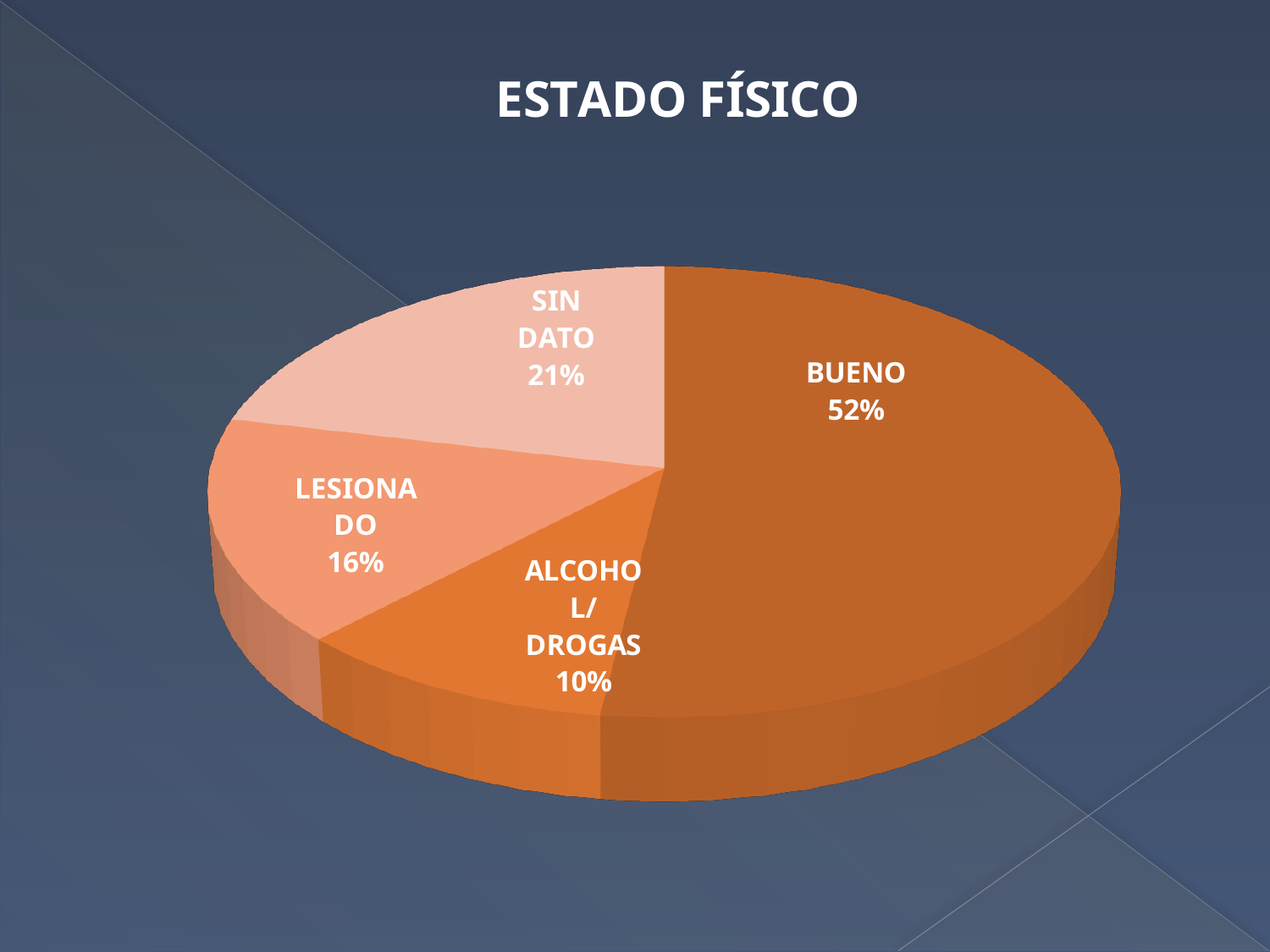
What is the combined share of LESIONADO and ALCOHOL/DROGAS? 26% How many slices does the pie chart have? 4 Which category has the largest share of the pie? BUENO What is the difference in percentage points between BUENO and SIN DATO? 31 What kind of chart is shown on the slide? pie chart Which is larger, the share for LESIONADO or the share for SIN DATO? SIN DATO What percentage is shown for ALCOHOL/DROGAS? 10% What percentage is shown for SIN DATO? 21% What is the title of the chart? ESTADO FÍSICO What percentage is shown for LESIONADO? 16% Which category has the smallest share of the pie? ALCOHOL/DROGAS What percentage is shown for BUENO? 52%